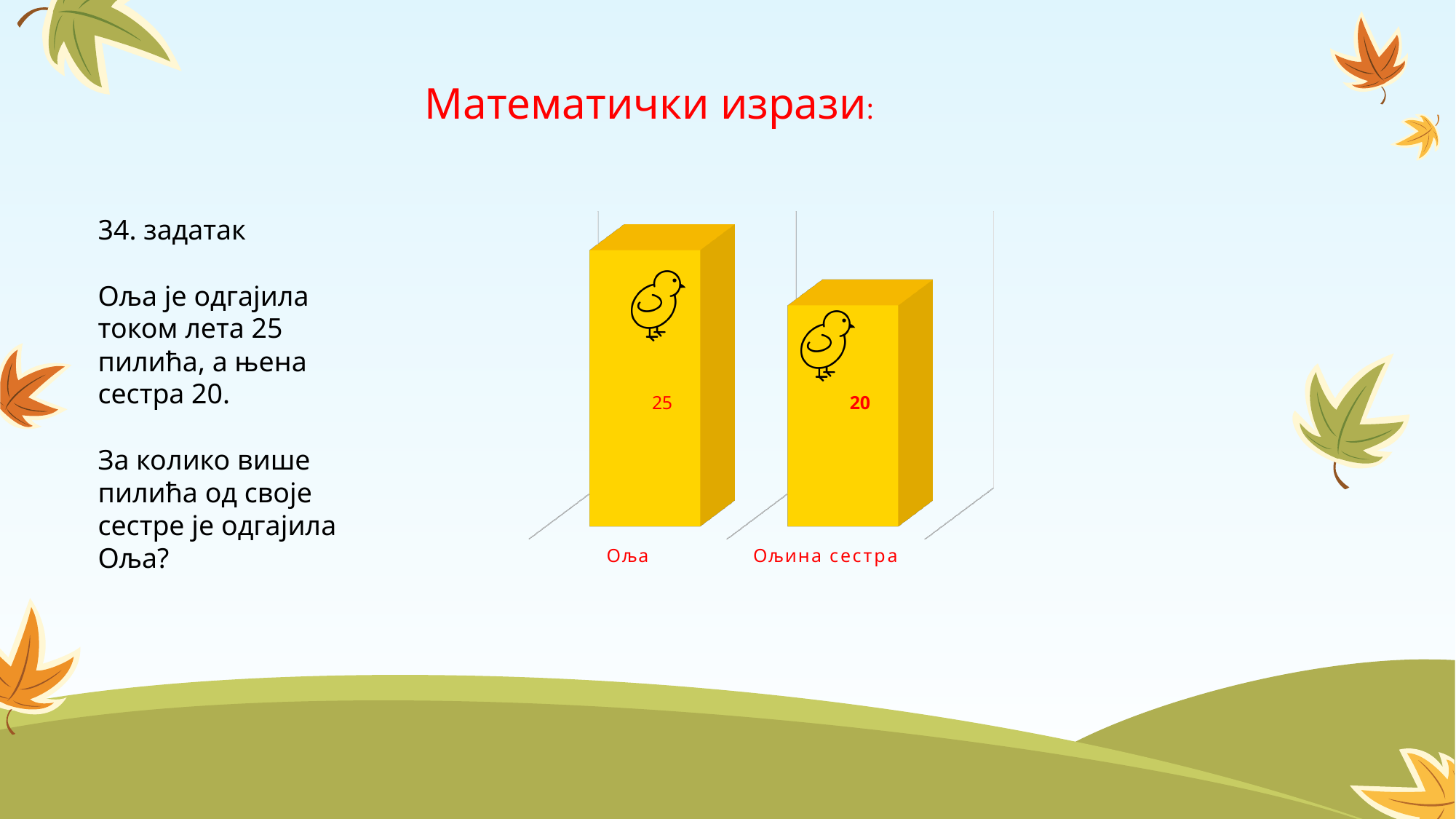
What kind of chart is shown on the slide? bar chart What colour are the bars in the chart? yellow What is the title of the slide? Математички изрази: Which category has the lowest value? Ољина сестра How many categories are shown in the chart? 2 What value is shown for Ољина сестра? 20 Which category has the highest value? Оља What is the difference between the values for Оља and Ољина сестра? 5 What is the total of the two values shown in the chart? 45 What value is shown for Оља? 25 Which is larger, the value for Оља or the value for Ољина сестра? Оља